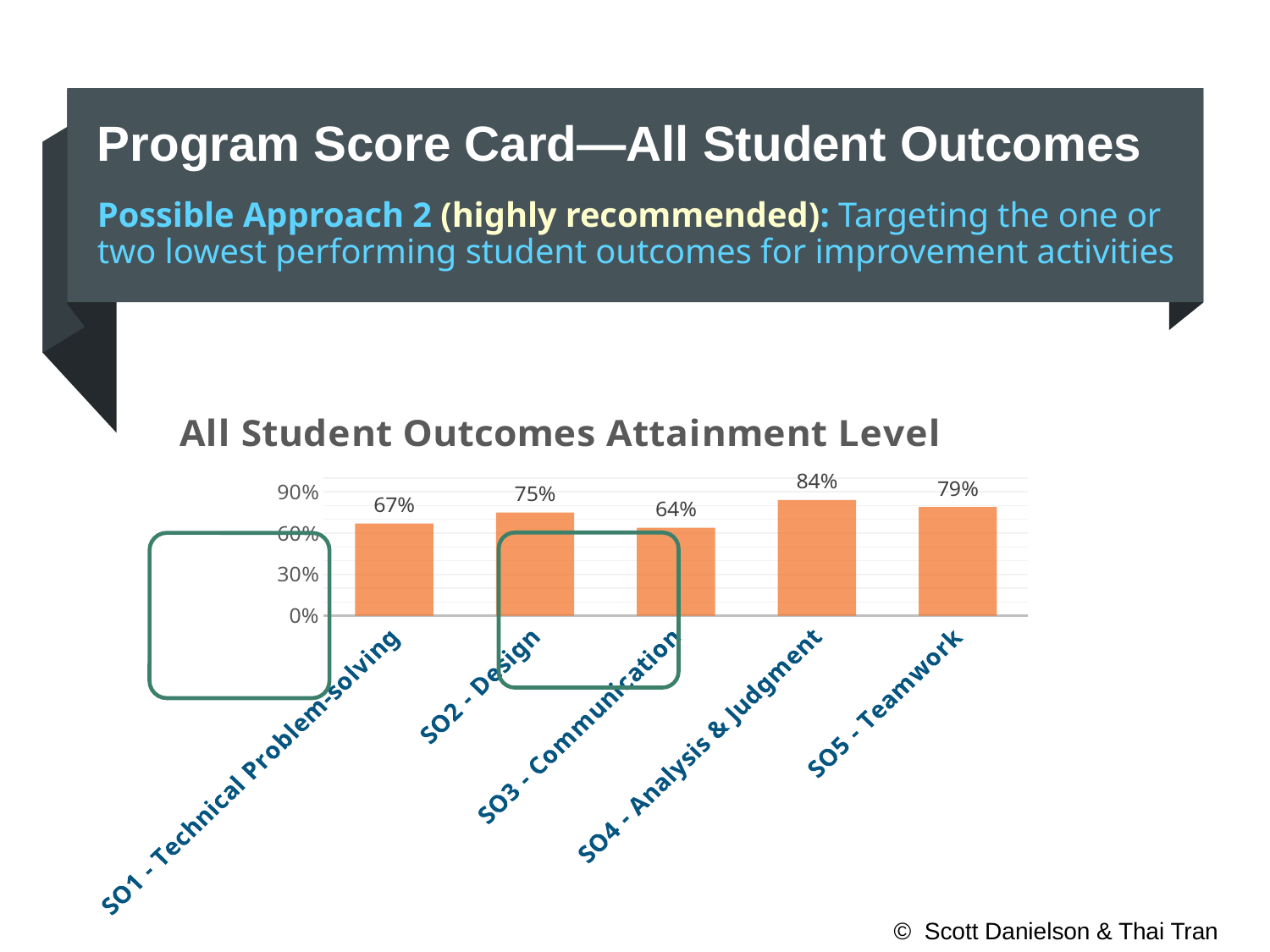
What is the difference between the attainment levels of SO4 - Analysis & Judgment and SO3 - Communication? 20% How many student outcomes are shown in the chart? 5 What kind of chart is used to show the attainment levels? Bar chart What is the difference between the attainment levels of SO2 - Design and SO1 - Technical Problem-solving? 8% What is the attainment level for SO1 - Technical Problem-solving? 67% What is the attainment level for SO4 - Analysis & Judgment? 84% What is the attainment level for SO3 - Communication? 64% Is the attainment level for SO2 - Design greater or less than 60%? greater Which student outcome has the lowest attainment level? SO3 - Communication Which has a higher attainment level, SO2 - Design or SO5 - Teamwork? SO5 - Teamwork Which student outcome has the highest attainment level? SO4 - Analysis & Judgment What is the title of the chart? All Student Outcomes Attainment Level